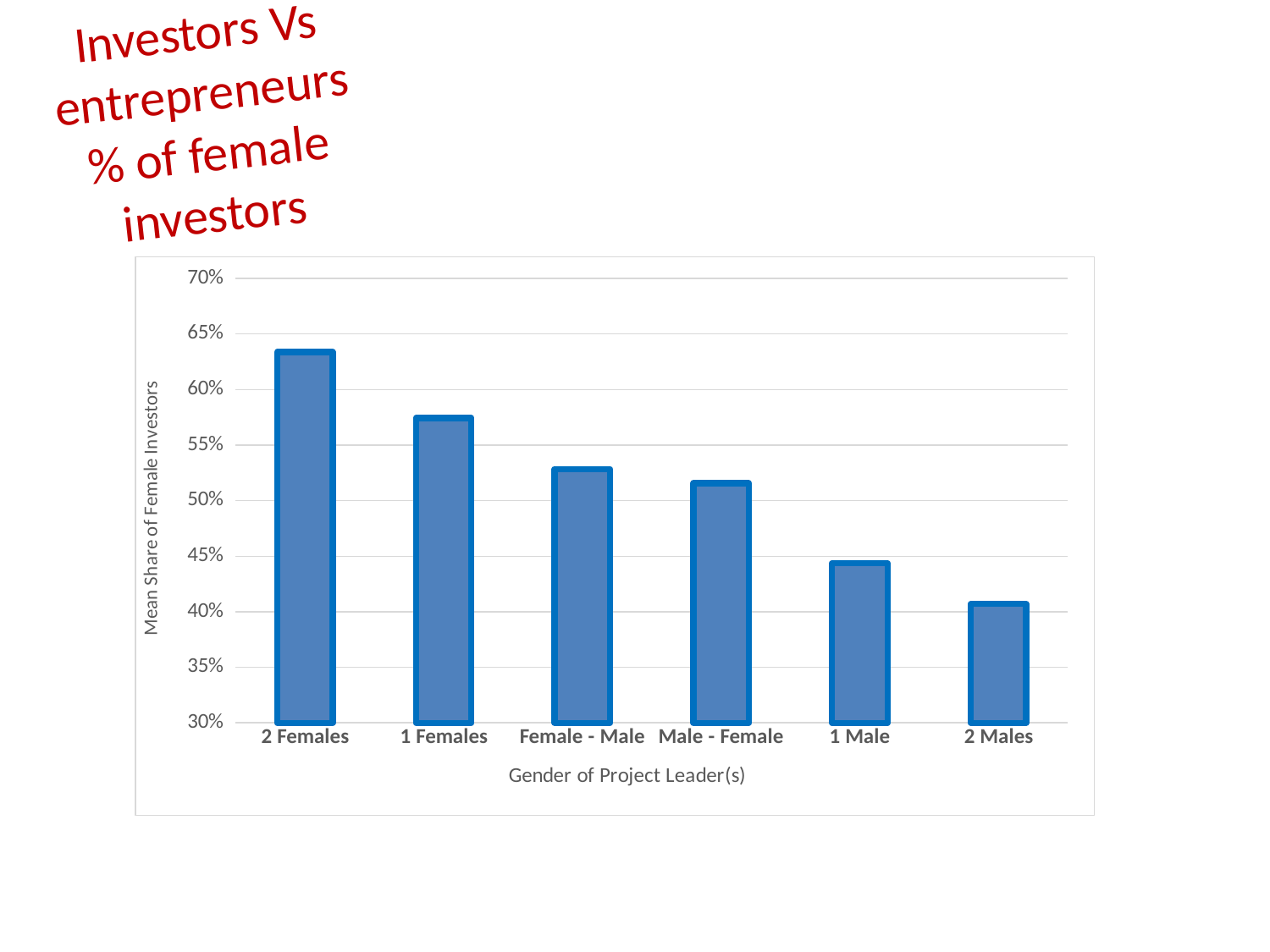
Which category has the highest mean share of female investors? 2 Females Which category has the lowest mean share of female investors? 2 Males What is the label of the x axis of the chart? Gender of Project Leader(s) Is the value for 1 Females greater or less than 55%? greater Do the values rise or fall moving from left to right along the x axis? fall Is the value for 2 Males greater or less than 45%? less What kind of chart is shown on the slide? bar chart How many categories are shown on the x axis of the chart? 6 Which has a higher mean share of female investors, 1 Females or 1 Male? 1 Females Is the value for 2 Females greater or less than 60%? greater